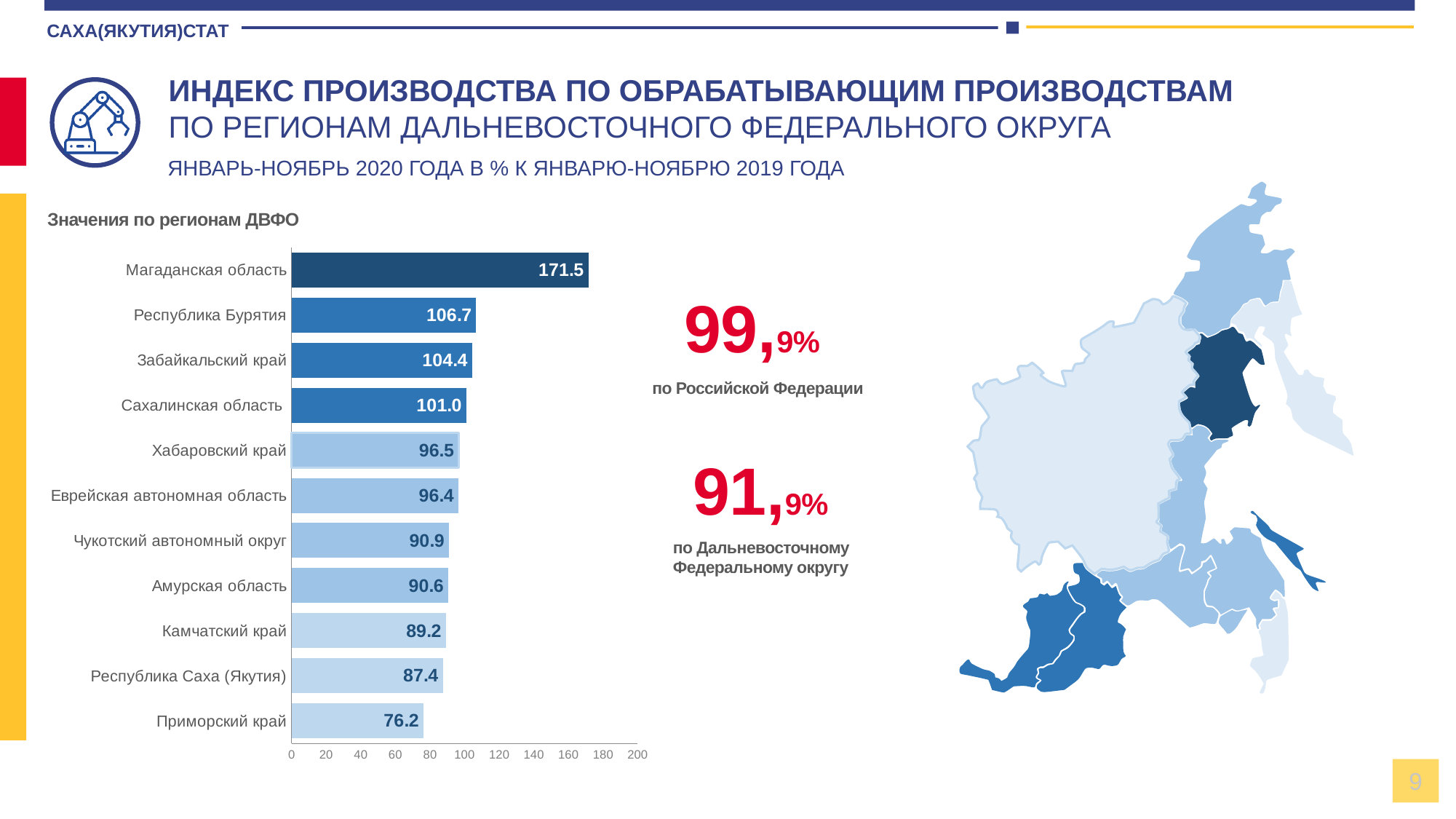
What is the value for Сахалинская область? 101.0 Which is larger, the value for Забайкальский край or the value for Камчатский край? Забайкальский край What is the difference between the values for Магаданская область and Приморский край? 95.3 What is the value for Магаданская область? 171.5 Which region has the lowest value in the chart? Приморский край How many regions are shown in the bar chart? 11 What kind of chart is shown on the slide? bar chart Is the value for Амурская область greater or less than 100? less What is the difference between the values for Республика Бурятия and Республика Саха (Якутия)? 19.3 What is the title printed above the bar chart? Значения по регионам ДВФО What is the value for Республика Саха (Якутия)? 87.4 Which region has the highest value in the chart? Магаданская область